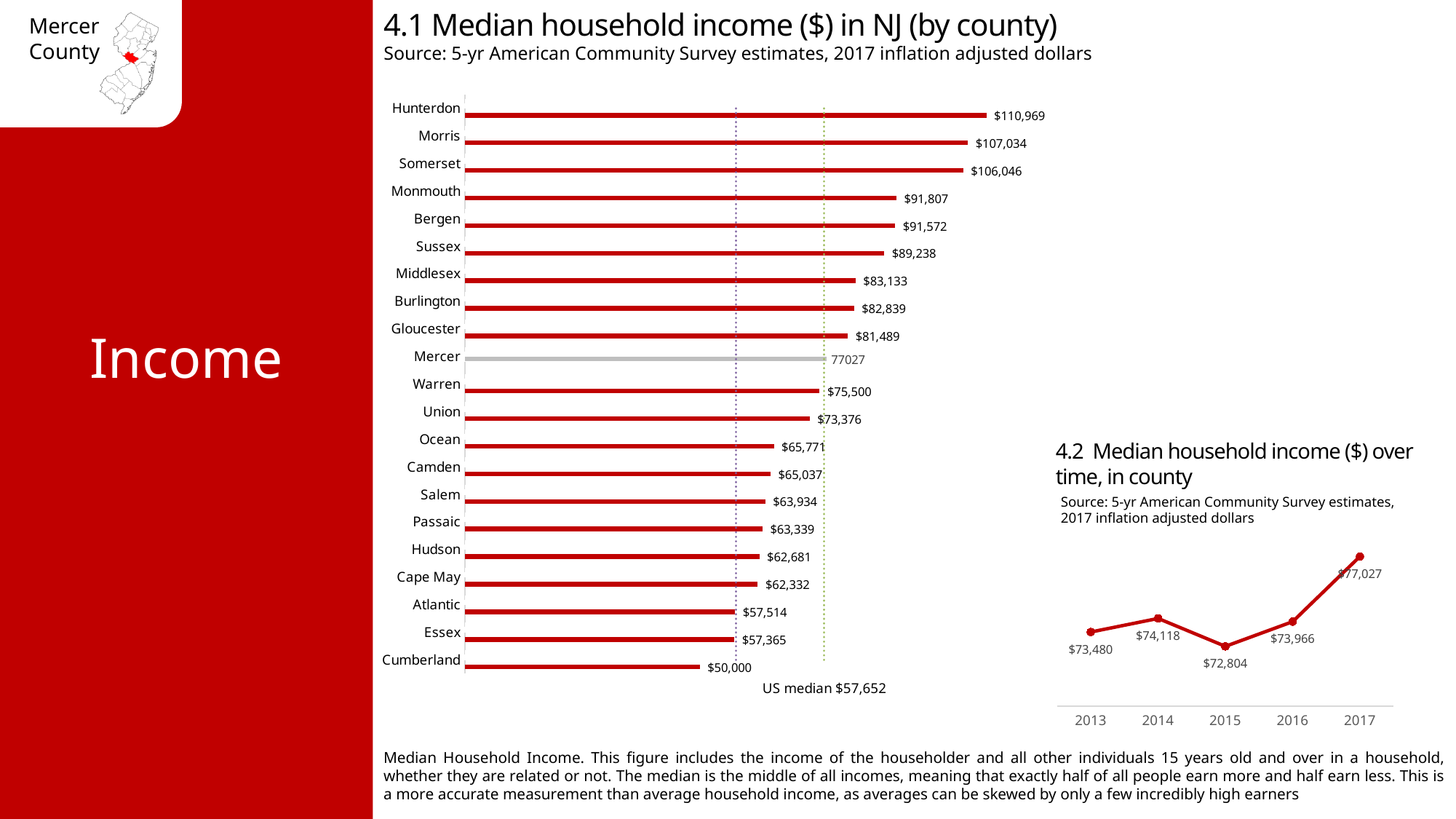
In chart 4.1 (Median household income in NJ by county), what is the difference between the median household income of Morris and Somerset? $988 In chart 4.1 (Median household income in NJ by county), which county has the highest median household income? Hunterdon In chart 4.1 (Median household income in NJ by county), what US median value is labelled on the chart? $57,652 In chart 4.1 (Median household income in NJ by county), which county has the lowest median household income? Cumberland In chart 4.2 (Median household income over time, in county), what is the value for 2015? $72,804 In chart 4.1 (Median household income in NJ by county), how many counties are plotted? 21 In chart 4.1 (Median household income in NJ by county), what is the median household income for Hunterdon? $110,969 What type of chart is chart 4.1 (Median household income in NJ by county)? Bar chart In chart 4.1 (Median household income in NJ by county), which county has a higher median household income, Union or Ocean? Union In chart 4.1 (Median household income in NJ by county), what is the median household income for Mercer? 77027 In chart 4.2 (Median household income over time, in county), which year has the highest median household income? 2017 In chart 4.2 (Median household income over time, in county), what is the difference between the 2017 and 2016 values? $3,061